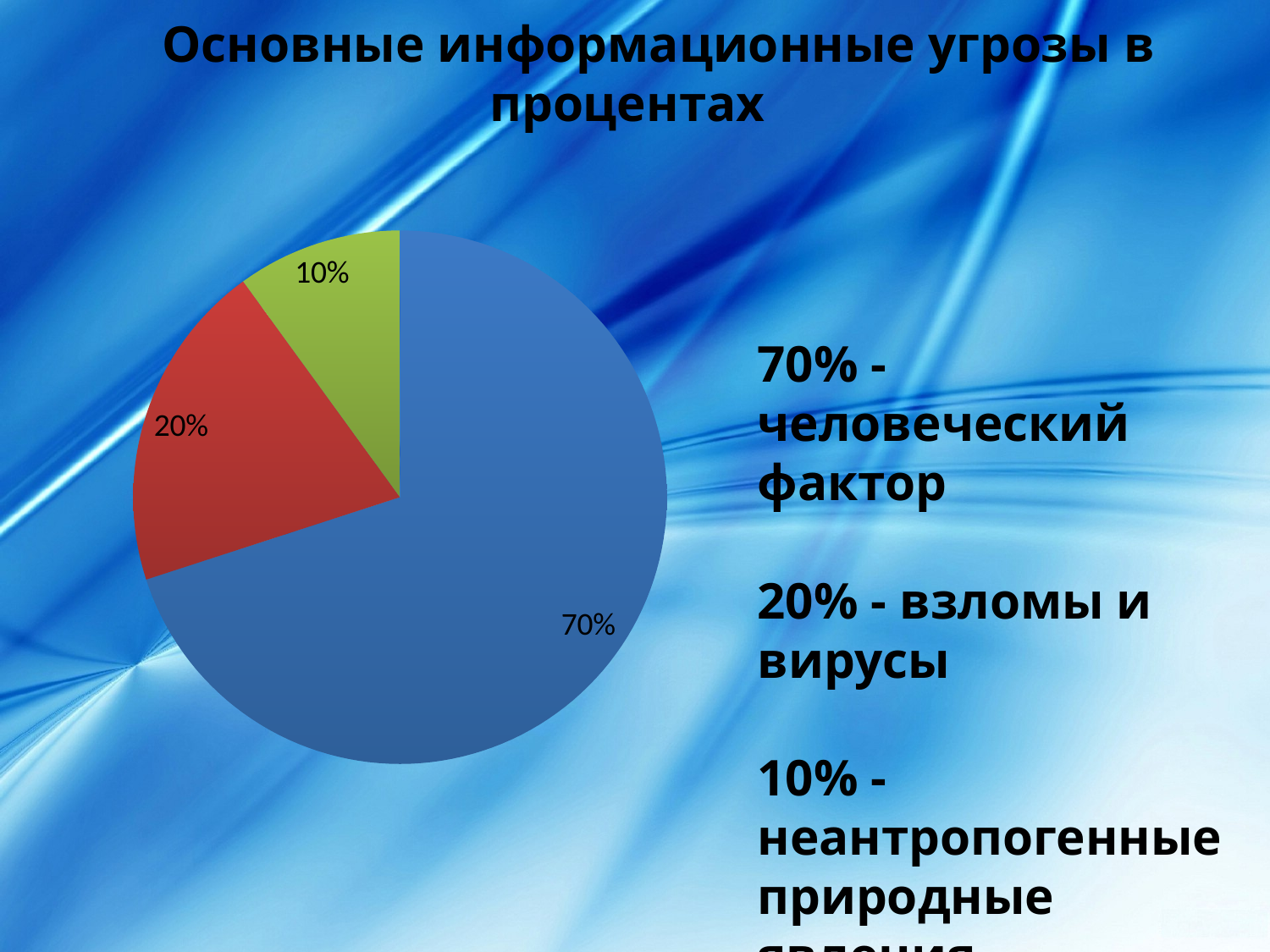
What share of the pie does the smallest slice represent? 10% How many slices does the pie chart have? 3 What is the title of the chart on the slide? Основные информационные угрозы в процентах What percentage is shown for the green slice of the pie chart? 10% What percentage is shown for the blue slice of the pie chart? 70% What percentage is shown for the red slice of the pie chart? 20% What is the difference between the largest slice (70%) and the smallest slice (10%)? 60% What kind of chart is shown on the slide? Pie chart Which is larger: the slice for взломы и вирусы or the slice for неантропогенные природные явления? взломы и вирусы According to the slide, which threat accounts for 70% of the pie? человеческий фактор According to the slide, what percentage is attributed to взломы и вирусы? 20% What share of the pie does the largest slice represent? 70%